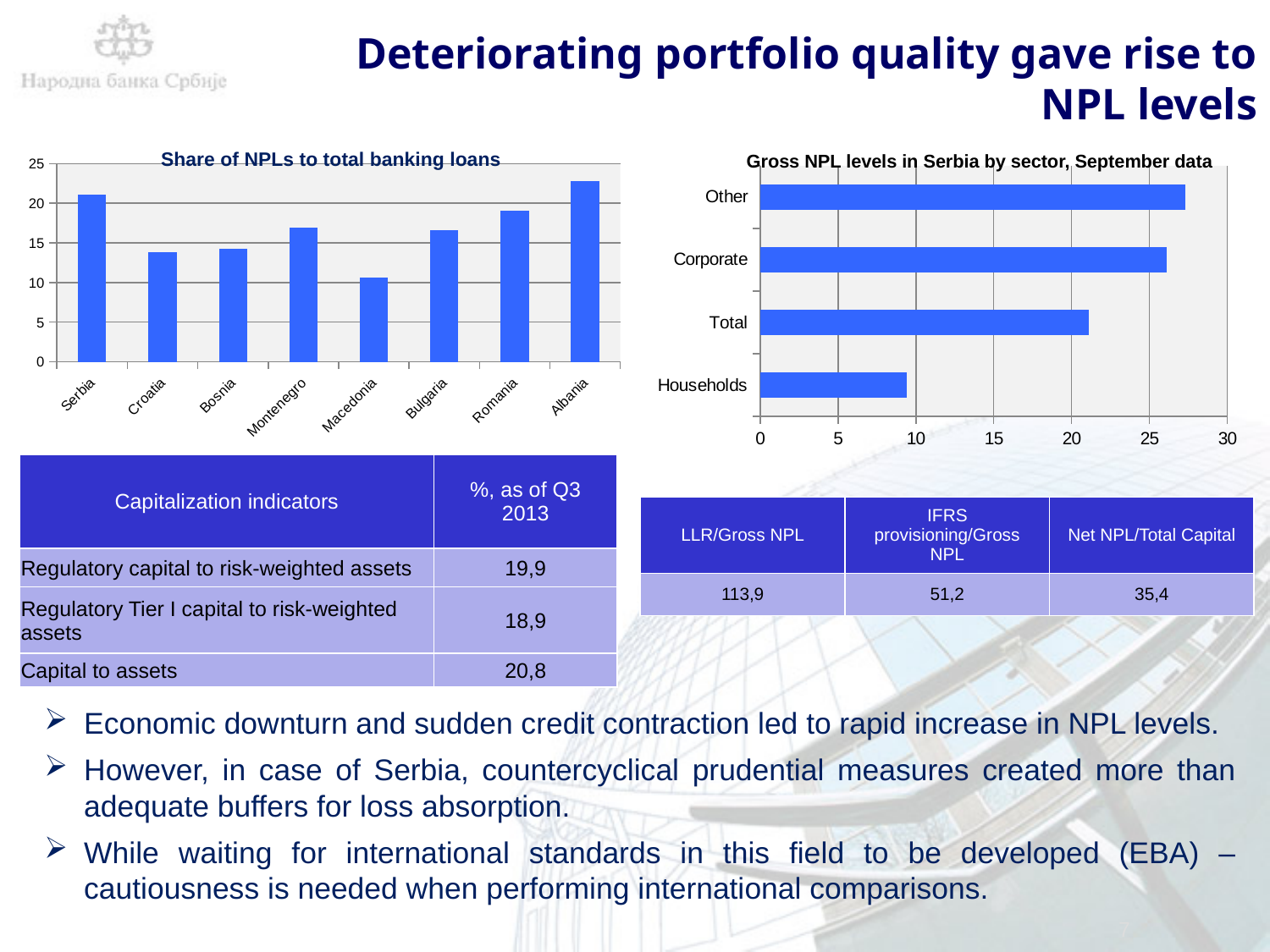
In the 'Share of NPLs to total banking loans' chart, is the value for Macedonia greater or less than 15? less In the 'Share of NPLs to total banking loans' chart, which country has the highest value? Albania In the 'Gross NPL levels in Serbia by sector, September data' chart, is the value for Households greater or less than 10? less In the 'Gross NPL levels in Serbia by sector, September data' chart, which is larger, the value for Corporate or the value for Total? Corporate In the 'Share of NPLs to total banking loans' chart, is the value for Serbia greater or less than 20? greater In the 'Share of NPLs to total banking loans' chart, which is larger, the value for Romania or the value for Croatia? Romania What kind of chart is the 'Share of NPLs to total banking loans' chart? bar chart How many sectors are shown in the 'Gross NPL levels in Serbia by sector, September data' chart? 4 How many countries are shown in the 'Share of NPLs to total banking loans' chart? 8 What kind of chart is the 'Gross NPL levels in Serbia by sector, September data' chart? bar chart In the 'Gross NPL levels in Serbia by sector, September data' chart, which sector has the lowest value? Households In the 'Share of NPLs to total banking loans' chart, which country has the lowest value? Macedonia